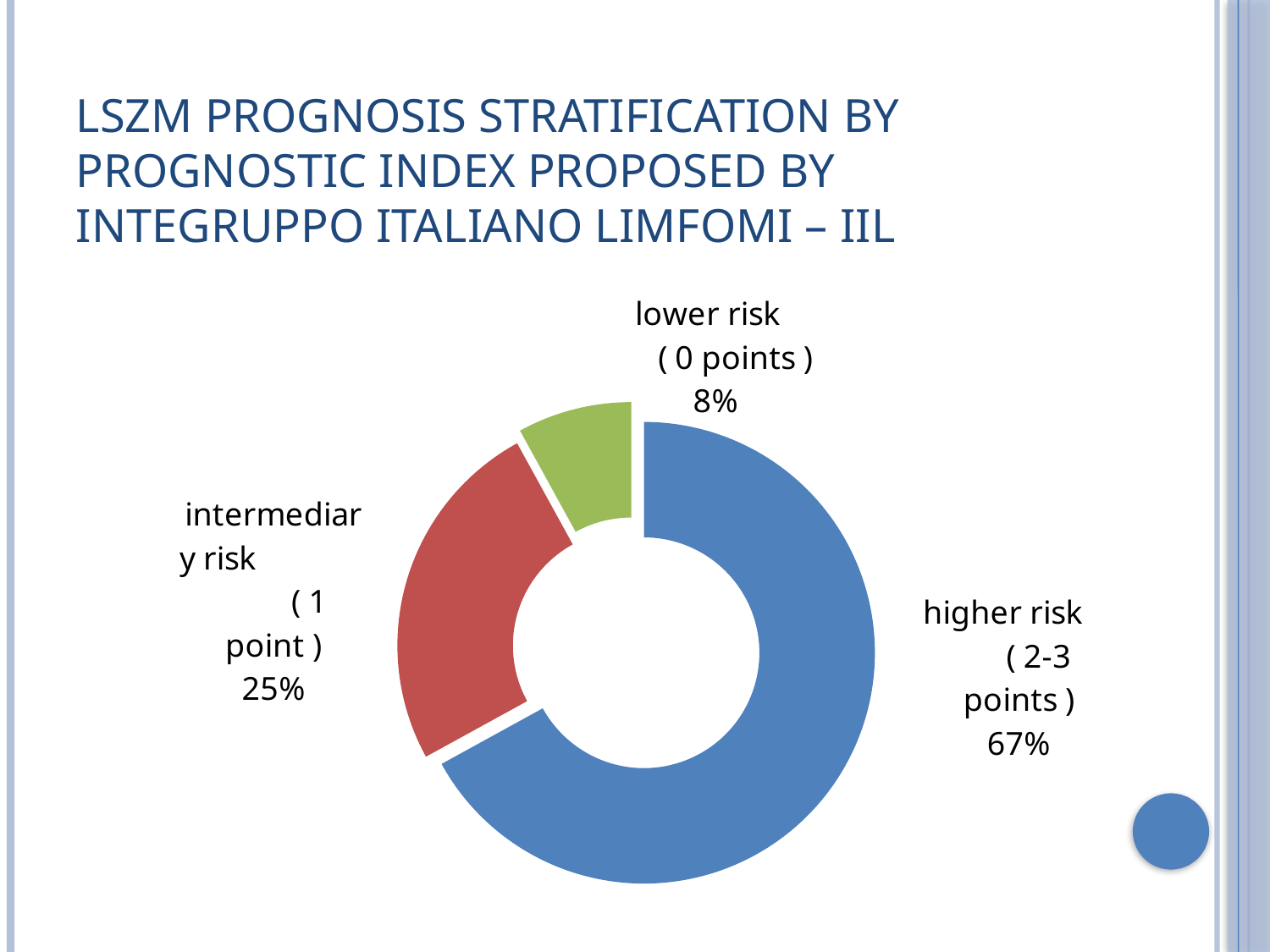
What colour is the higher risk slice? blue Which risk category has the largest share? higher risk (2-3 points) What share of the chart is the lower risk (0 points) slice? 8% What kind of chart is shown on the slide? doughnut (pie) chart Which risk category has the smallest share? lower risk (0 points) What colour is the lower risk slice? green What is the difference in percentage points between the higher risk and intermediary risk slices? 42 What share of the chart is the higher risk (2-3 points) slice? 67% What share of the chart is the intermediary risk (1 point) slice? 25% What is the difference in percentage points between the intermediary risk and lower risk slices? 17 How many risk categories are shown in the chart? 3 Which is larger, the intermediary risk slice or the lower risk slice? intermediary risk